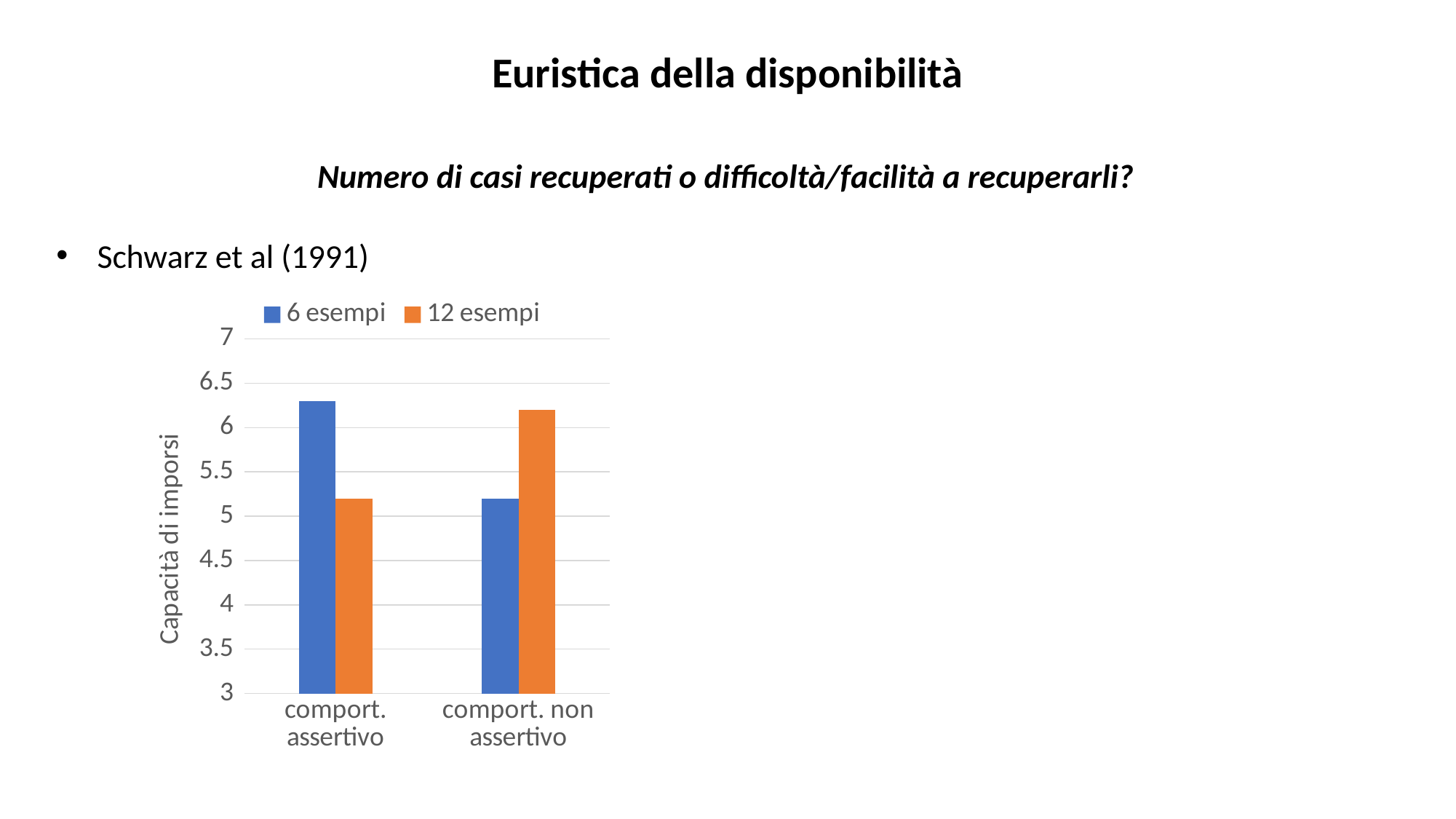
How many categories are shown on the x axis of the chart? 2 For the '12 esempi' series, which category has the higher value? comport. non assertivo In the 'comport. assertivo' category, which series has the larger value, '6 esempi' or '12 esempi'? 6 esempi How many series does the chart legend list? 2 For the '6 esempi' series, which category has the higher value? comport. assertivo Is the value for '12 esempi' in the 'comport. assertivo' category greater or less than 5.5? less In the 'comport. non assertivo' category, which series has the larger value, '6 esempi' or '12 esempi'? 12 esempi What kind of chart is shown on the slide? bar chart Is the value for '6 esempi' in the 'comport. non assertivo' category greater or less than 5.5? less Is the value for '12 esempi' in the 'comport. non assertivo' category greater or less than 6? greater What is the title of the vertical axis of the chart? Capacità di imporsi